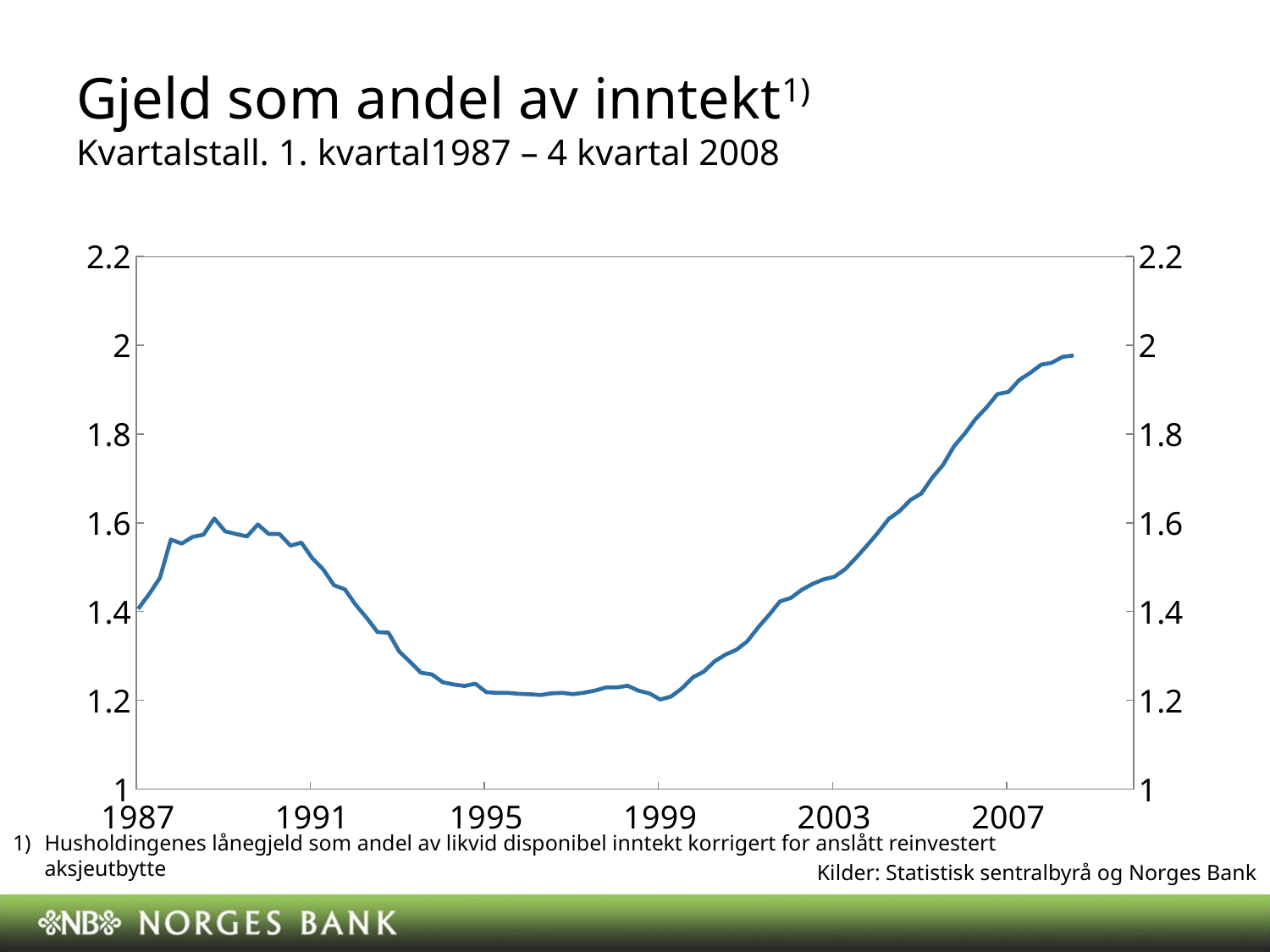
Is the value for 1991 greater or less than 1.4? greater What kind of chart is shown on the slide? line chart Around which year labelled on the x axis does the line reach its lowest point? 1999 What is the title of the chart? Gjeld som andel av inntekt Is the value at the end of the series (2008) higher or lower than the value at the start (1987)? higher Is the value for 1995 greater or less than 1.4? less Is the value for 2003 greater or less than 1.4? greater Does the line rise or fall between 1991 and 1995? fall What is the highest value shown on the y axis? 2.2 Does the line rise or fall between 1999 and 2007? rise